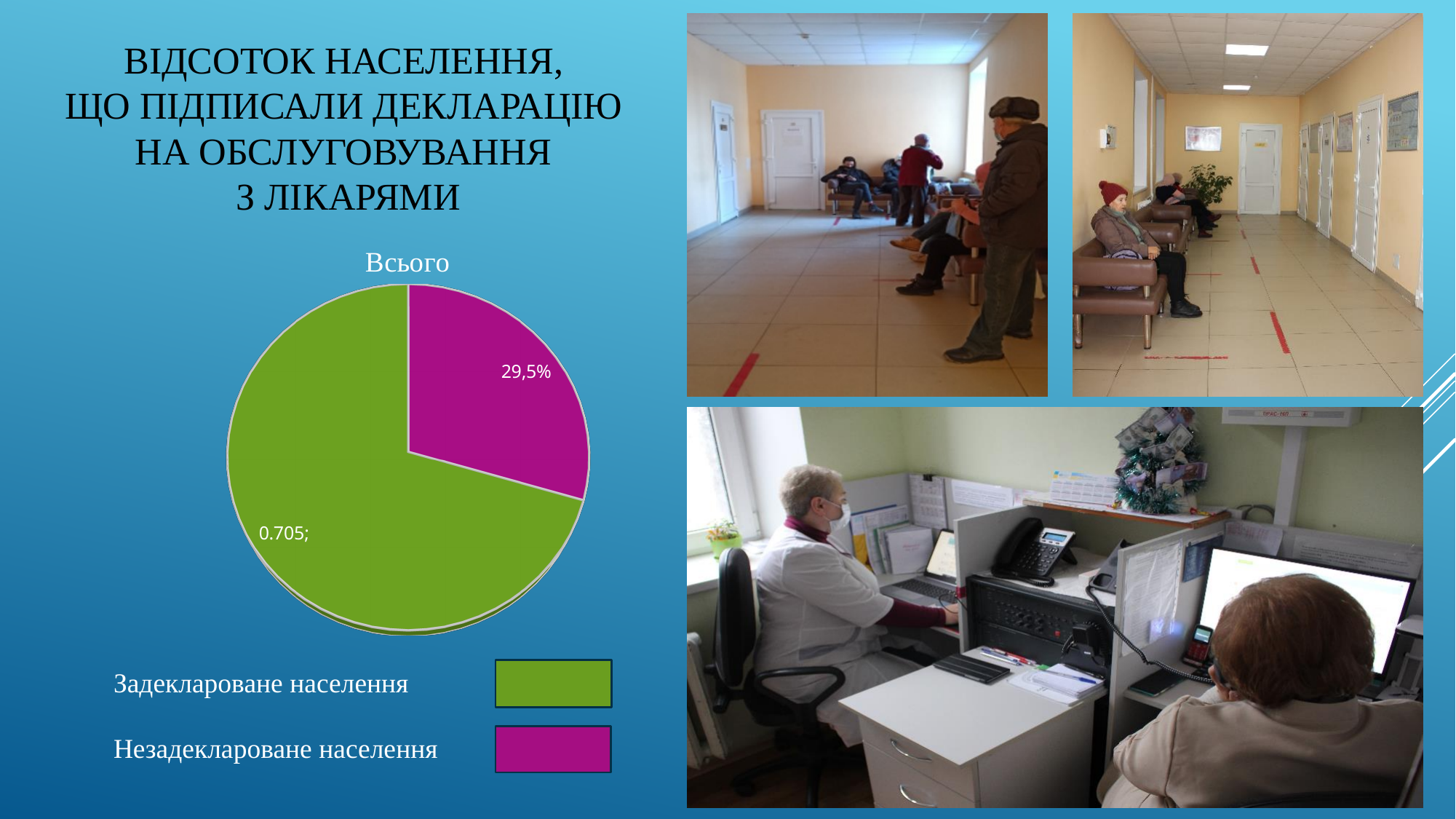
What value is printed on the green slice of the pie chart? 0.705 What share of the pie does the Незадеклароване населення slice represent? 29,5% How many slices does the pie chart have? 2 Which category has the smallest slice in the pie chart? Незадеклароване населення What is the title of the pie chart? Всього How many categories does the legend list? 2 Which category has the largest slice in the pie chart? Задеклароване населення What value is printed on the magenta slice of the pie chart? 29,5% Which colour represents Незадеклароване населення in the legend? magenta Which slice is larger: Задеклароване населення or Незадеклароване населення? Задеклароване населення What kind of chart is shown on the slide? pie chart